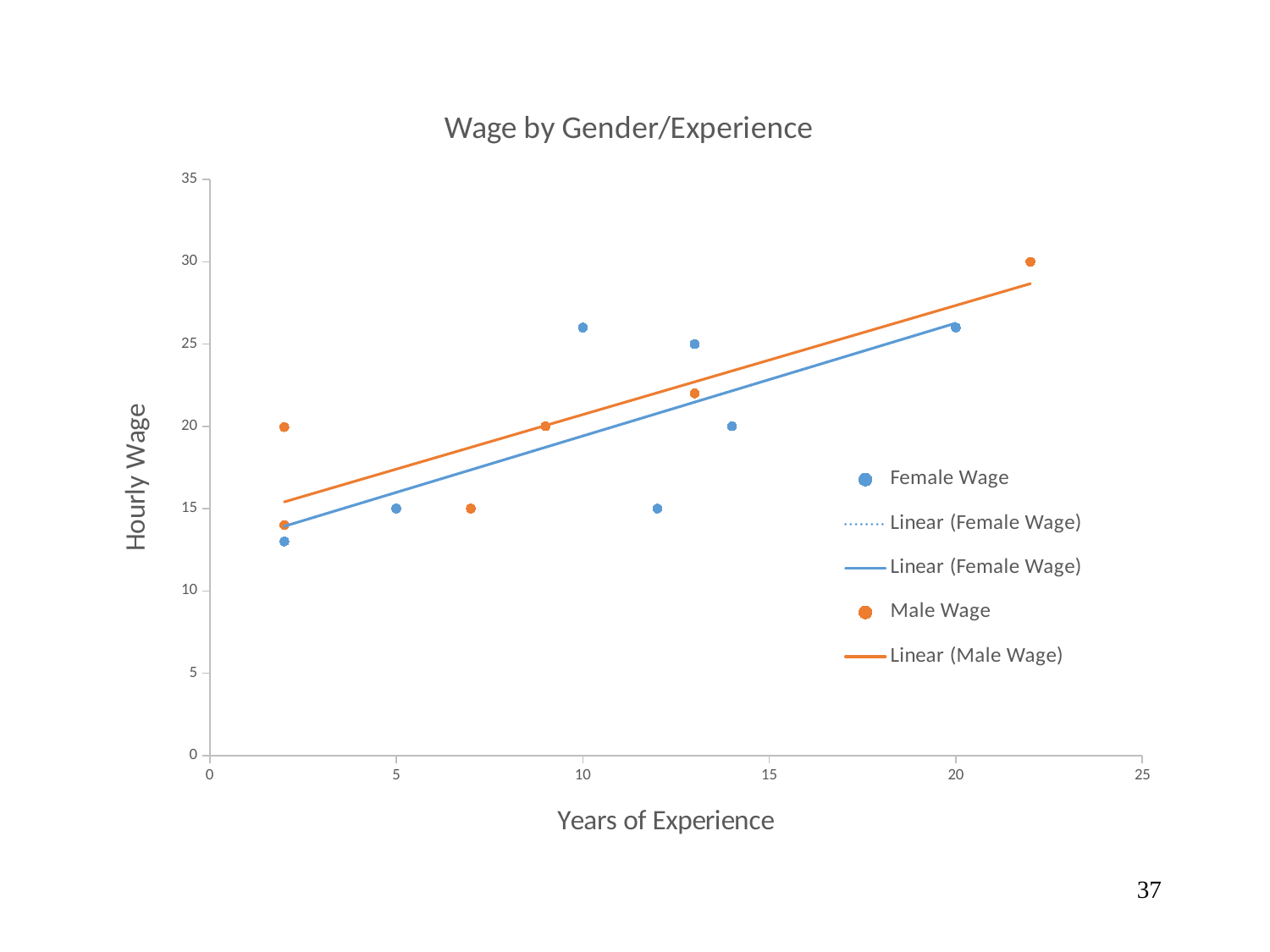
What kind of chart is shown on the slide? Scatter chart How many Male Wage data points are plotted? 6 Is the hourly wage of the Female Wage point at 10 years of experience greater or less than 25? greater Is the hourly wage of the Female Wage point at 2 years of experience greater or less than 15? less What is the label of the vertical axis? Hourly Wage What is the hourly wage of the Male Wage point at 22 years of experience? 30 What is the title of the chart? Wage by Gender/Experience How many entries does the legend list? 5 Do hourly wages generally rise or fall as years of experience increase, according to the trend lines? Rise Which series contains the highest hourly wage point on the chart? Male Wage What is the hourly wage of the Female Wage point at 5 years of experience? 15 How many Female Wage data points are plotted? 7